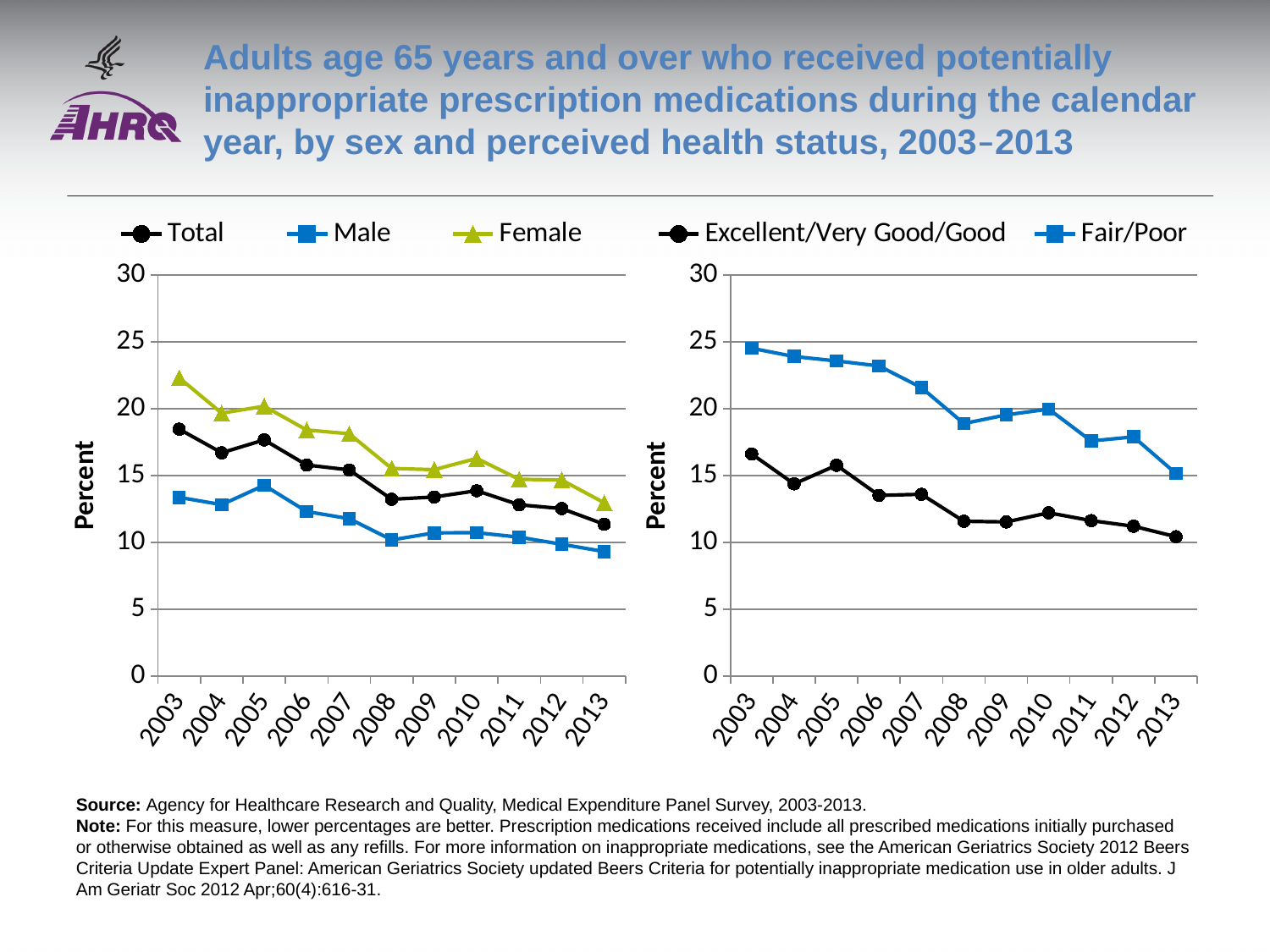
In the right chart, is the value for Fair/Poor in 2013 greater or less than 20? less How many series does the legend of the right chart (by perceived health status) list? 2 In the left chart, is the value for Female in 2003 greater or less than 20? greater How many years are shown on the x axis of the left chart? 11 In the left chart, does the Female line rise or fall from 2003 to 2013? Fall What is the label on the y axis of the right chart? Percent How many series does the legend of the left chart list? 3 In the left chart, which series has the highest value in 2003? Female What kind of chart is the left chart (Total, Male, Female)? Line chart In the right chart, which is larger in 2003: Fair/Poor or Excellent/Very Good/Good? Fair/Poor In the left chart, which series has the lowest value in 2013? Male In the left chart, is the value for Male in 2013 greater or less than 10? less